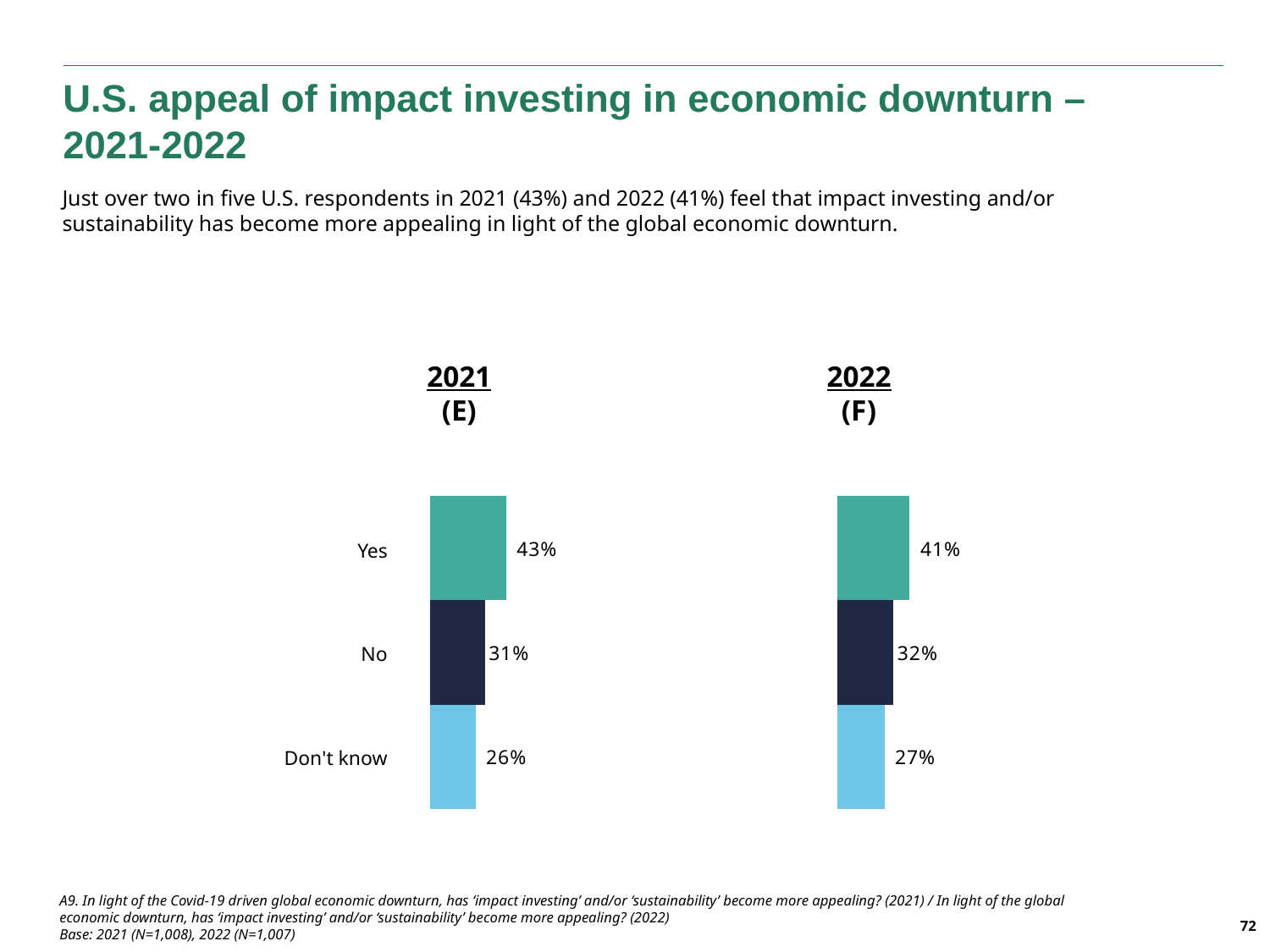
In the 2021 (E) chart, what is the difference between the Yes and No values? 12 percentage points In the 2021 (E) chart, what colour is the bar for the Yes category? Green How many response categories are shown in the 2021 (E) chart? 3 In the 2022 (F) chart, which response category has the highest value? Yes In the 2022 (F) chart, what percentage of respondents answered Yes? 41% What type of chart is used to show the 2022 (F) results? Bar chart In the 2021 (E) chart, what percentage of respondents answered Yes? 43% Is the Don't know value larger in the 2021 (E) chart or the 2022 (F) chart? 2022 (F) In the 2021 (E) chart, what percentage of respondents answered Don't know? 26% In the 2021 (E) chart, which response category has the lowest value? Don't know What is the difference between the Yes value in the 2021 (E) chart and the Yes value in the 2022 (F) chart? 2 percentage points In the 2022 (F) chart, what percentage of respondents answered No? 32%